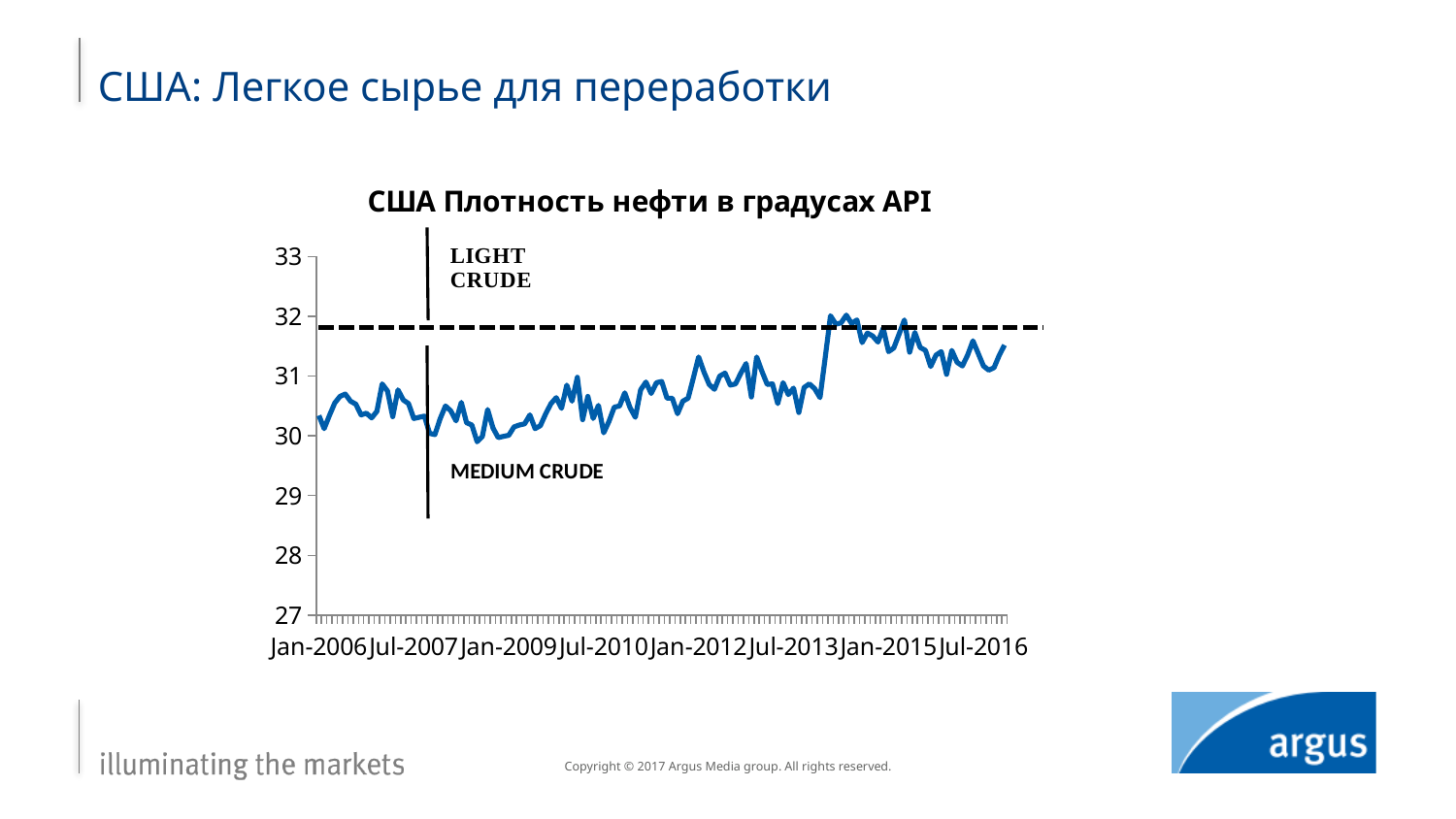
Which is higher, the value at Jan-2006 or the value at Jan-2015? Jan-2015 Does the plotted line ever fall below 29 on the y axis? no How many date labels are shown on the x axis? 8 Is the value at Jan-2009 greater or less than 31? less Is the value at Jan-2006 greater or less than 31? less What kind of chart is shown on the slide? line chart Which label appears above the dashed horizontal line on the chart? LIGHT CRUDE What is the title of the chart? США Плотность нефти в градусах API Which is higher, the value at Jan-2009 or the value at Jul-2016? Jul-2016 Overall, does the plotted line rise or fall from Jan-2006 to Jul-2016? rise